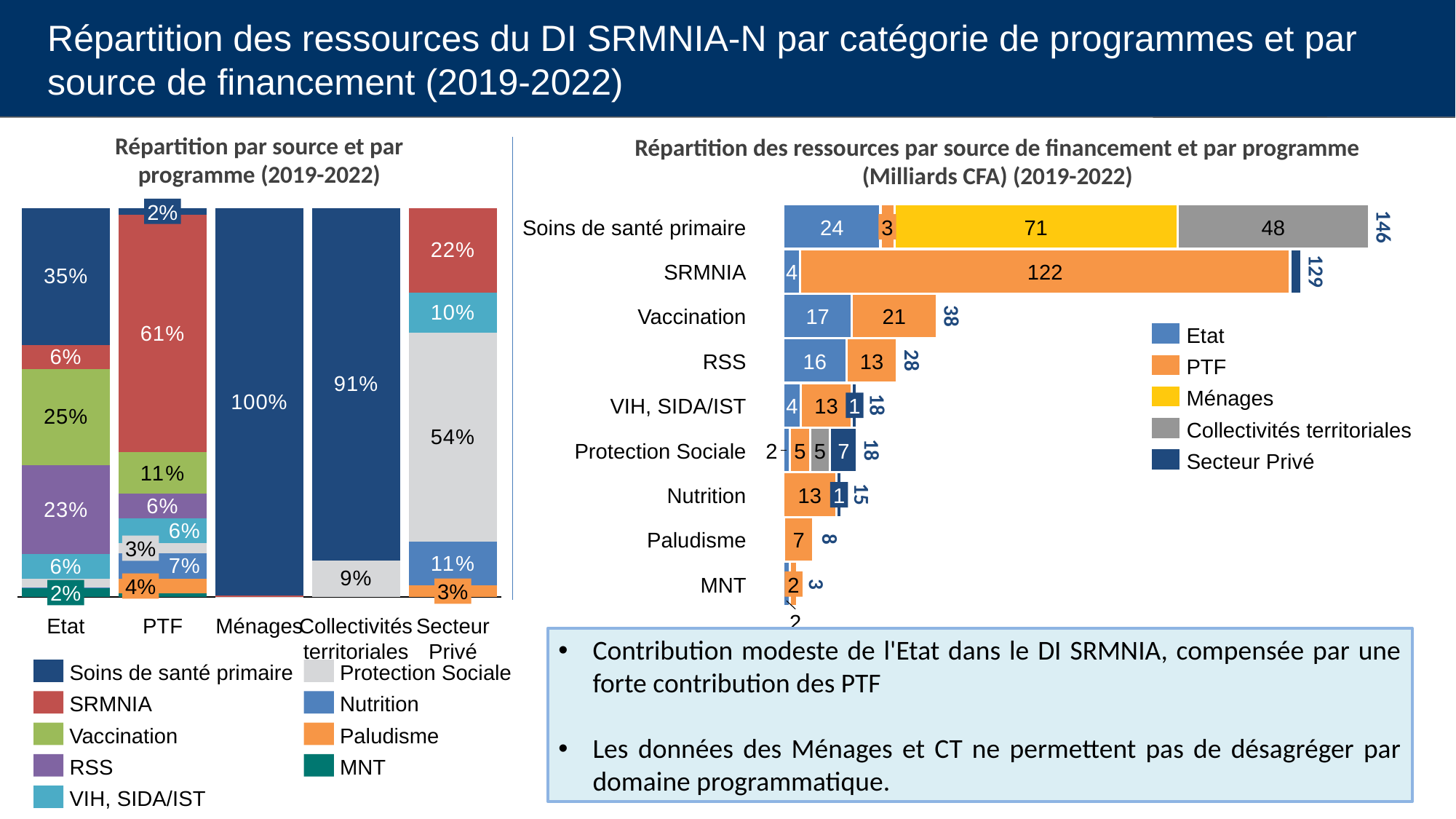
In the left chart (Répartition par source et par programme), what share of Etat resources goes to Vaccination? 25% In the left chart, what share of Secteur Privé resources goes to Protection Sociale? 54% In the right chart, which programme has the lowest total? MNT In the left chart, what share of PTF resources goes to SRMNIA? 61% In the right chart, which programme has the highest total? Soins de santé primaire What kind of chart is the right chart? Stacked horizontal bar chart In the right chart, what is the difference between the Etat values for Vaccination and RSS? 1 In the right chart (Répartition des ressources par source de financement et par programme), what is the total for Soins de santé primaire? 146 In the right chart, what is the PTF value for SRMNIA? 122 In the right chart, how many series does the legend list? 5 In the right chart, how many programmes are shown on the vertical axis? 9 In the right chart, which is larger: the Ménages value or the Collectivités territoriales value for Soins de santé primaire? Ménages